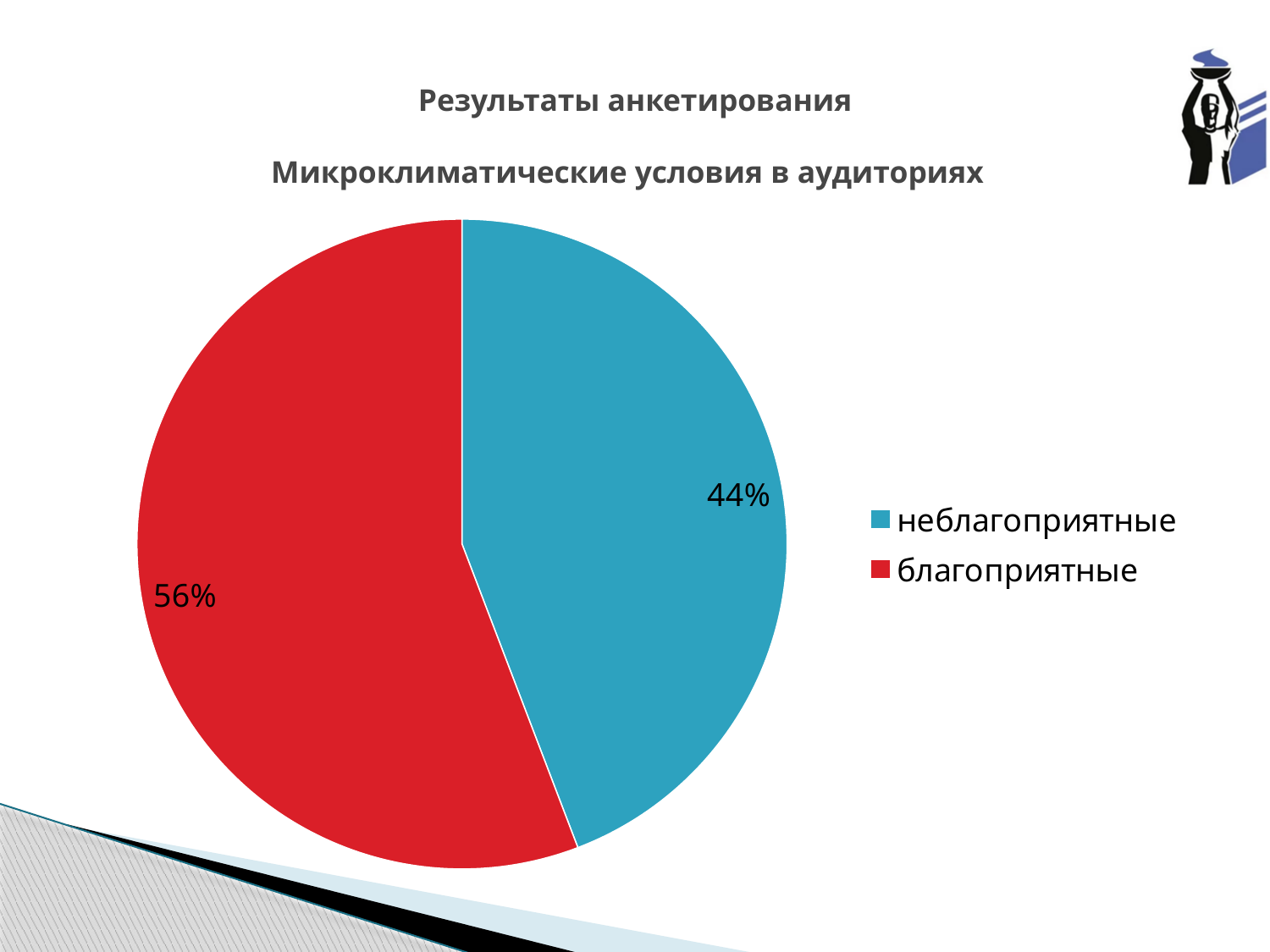
Which category has the smallest slice of the pie? неблагоприятные Which category has the largest slice of the pie? благоприятные What share of the pie is labelled "неблагоприятные"? 44% What kind of chart is shown on the slide? pie chart What share of the pie is labelled "благоприятные"? 56% What is the title of the chart? Микроклиматические условия в аудиториях How many entries does the legend list? 2 What is the difference in percentage points between the "благоприятные" and "неблагоприятные" slices? 12 What colour is the "благоприятные" slice? red How many slices does the pie chart have? 2 Which slice is larger, "благоприятные" or "неблагоприятные"? благоприятные